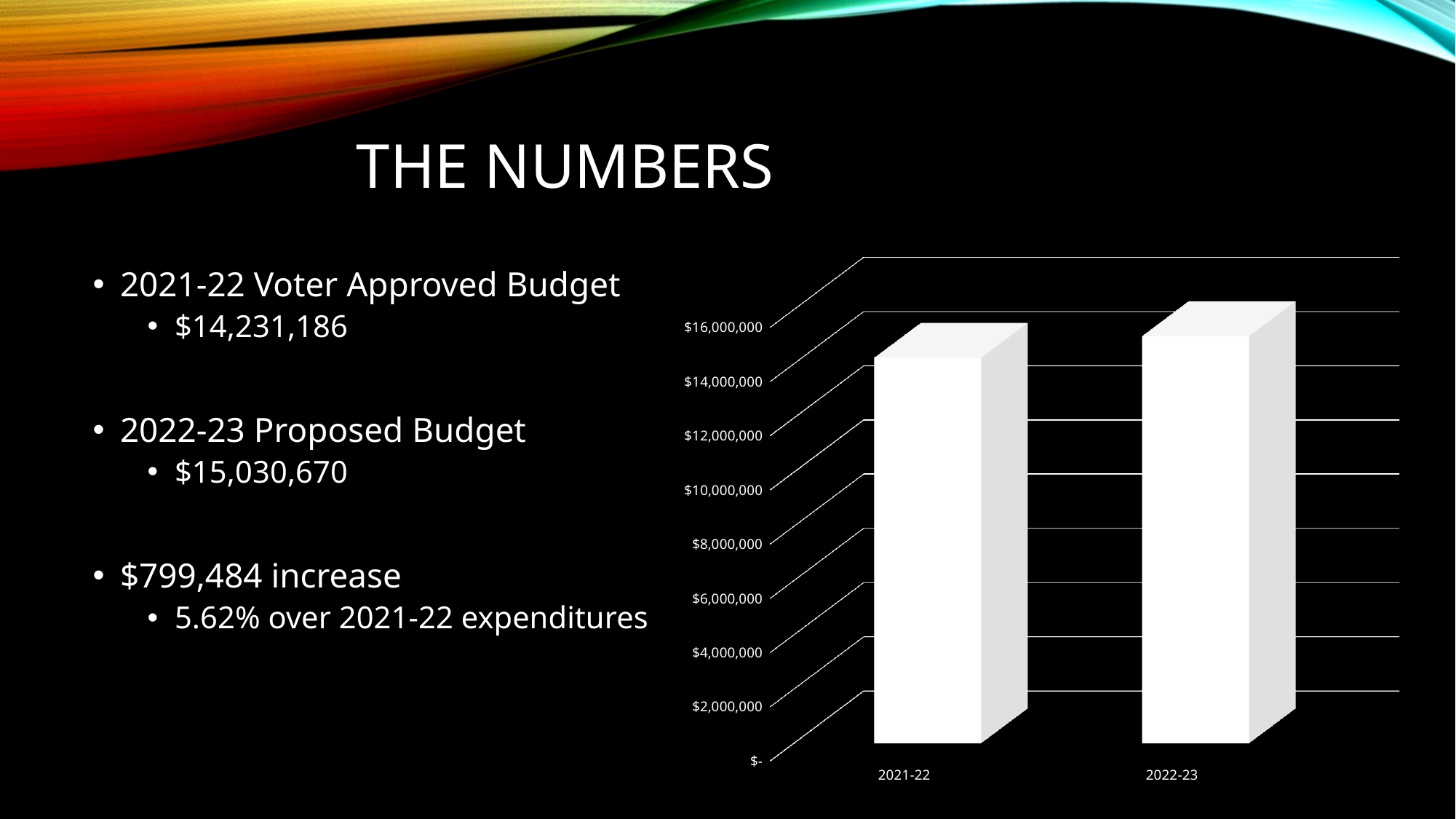
What is the difference between the 2022-23 and 2021-22 budget values? $799,484 What is the 2022-23 Proposed Budget value plotted for 2022-23? $15,030,670 Which category has the taller bar, 2021-22 or 2022-23? 2022-23 How many categories are plotted on the chart? 2 What is the highest tick label shown on the vertical axis of the chart? $16,000,000 What kind of chart is shown on the slide? bar chart Which category has the lowest value on the chart? 2021-22 What is the 2021-22 Voter Approved Budget value plotted for 2021-22? $14,231,186 Is the value for 2021-22 greater or less than $12,000,000? greater Do the values rise or fall from 2021-22 to 2022-23? rise Which category has the highest value on the chart? 2022-23 Is the value for 2022-23 greater or less than $14,000,000? greater